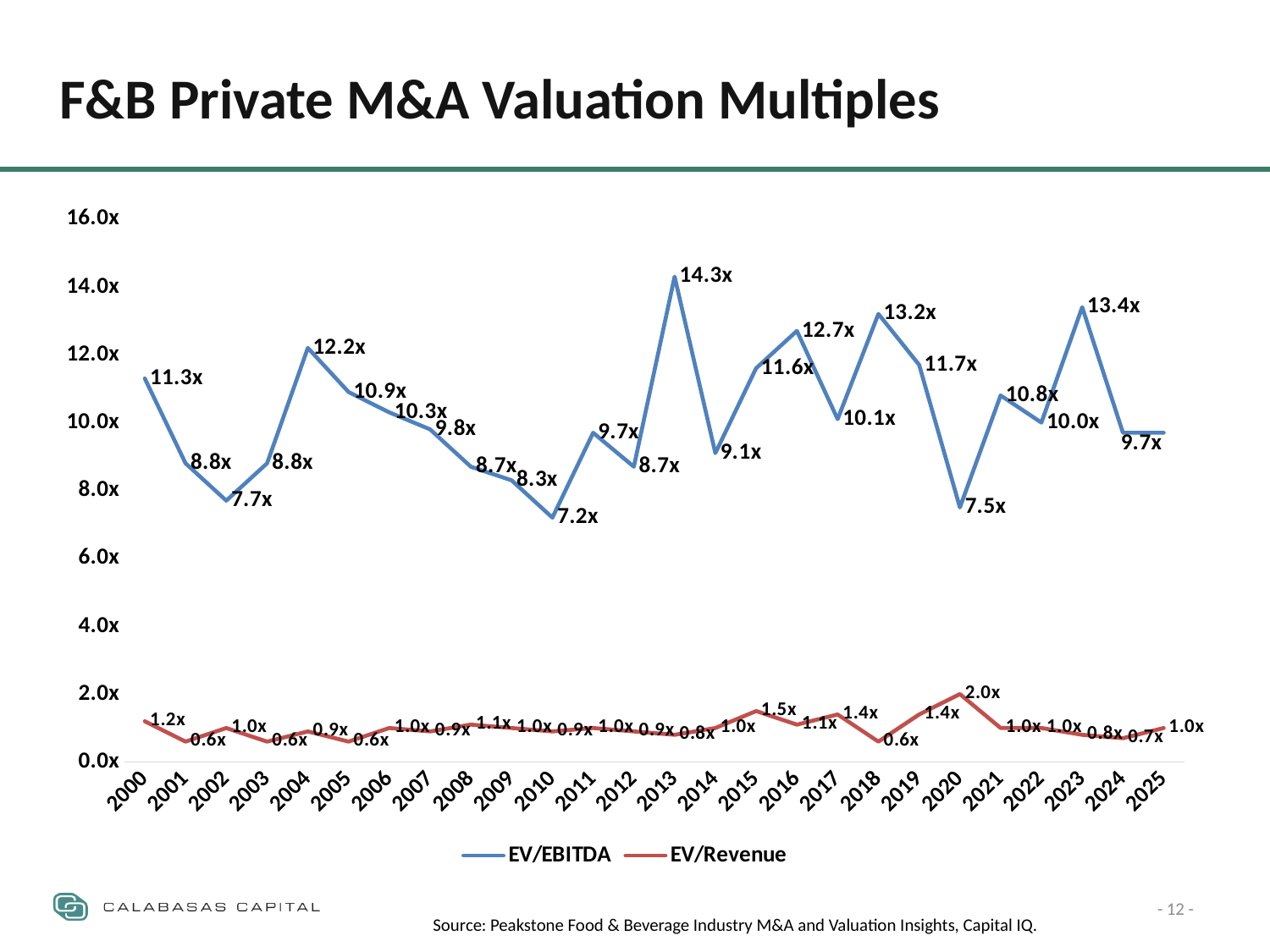
What is the EV/Revenue multiple for 2020? 2.0x What is the EV/EBITDA multiple for 2013? 14.3x In which year is the EV/EBITDA multiple lowest? 2010 What is the EV/Revenue multiple for 2015? 1.5x What is the EV/EBITDA multiple for 2004? 12.2x In which year is the EV/Revenue multiple highest? 2020 How many series does the legend list? 2 In which year is the EV/EBITDA multiple highest? 2013 What type of chart is shown on the slide? Line chart Is the EV/EBITDA value for 2023 greater or less than 12.0x? greater What is the difference between the EV/EBITDA multiples for 2013 and 2010? 7.1x Which year has the higher EV/EBITDA multiple, 2018 or 2020? 2018